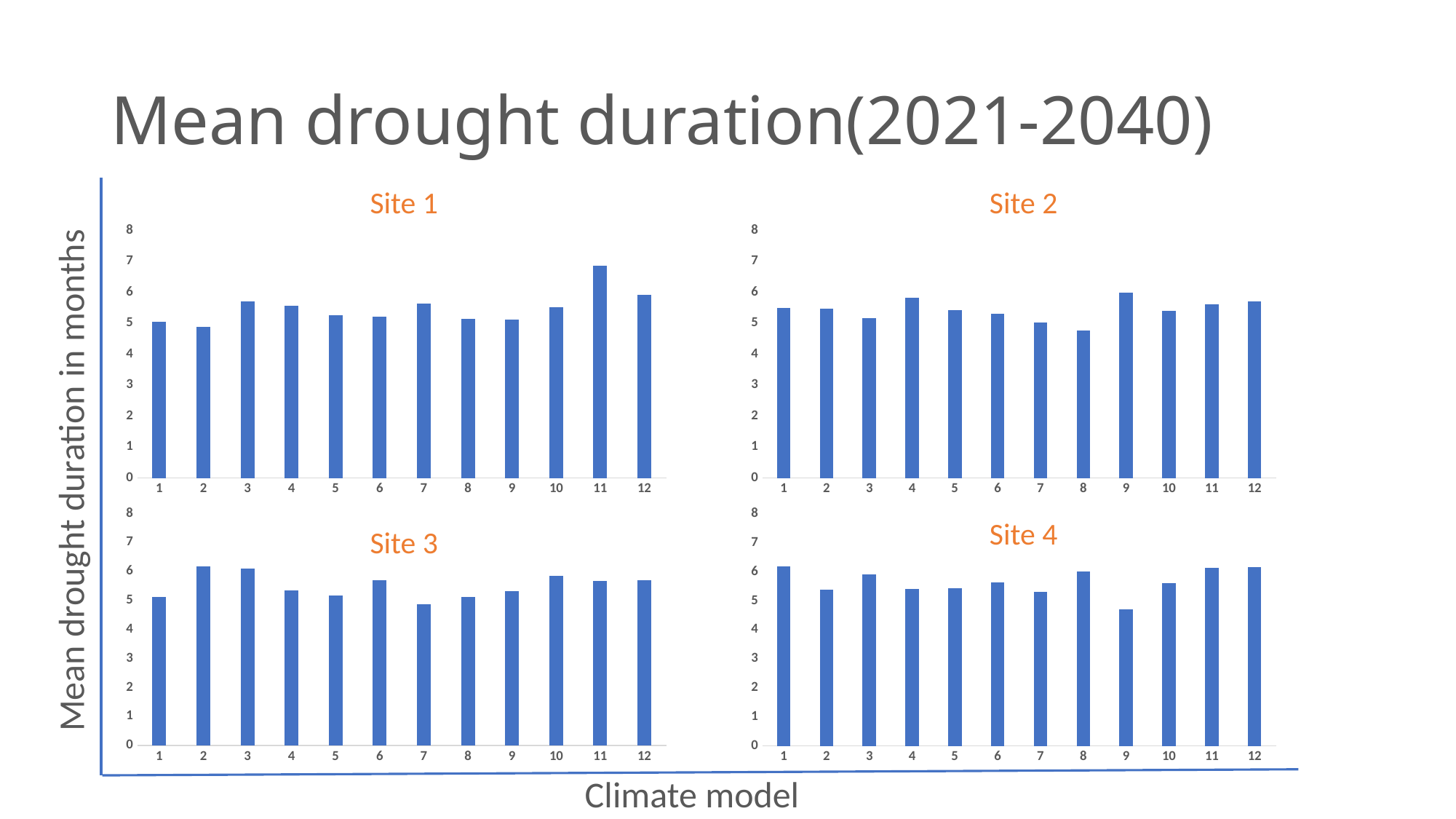
In the Site 4 chart, which is larger, the value for climate model 1 or climate model 9? climate model 1 In the Site 2 chart, is the value for climate model 8 greater or less than 5? less In the Site 3 chart, is the value for climate model 2 greater or less than 6? greater In the Site 1 chart, which climate model has the highest mean drought duration? 11 In the Site 4 chart, which climate model has the lowest mean drought duration? 9 In the Site 2 chart, which climate model has the lowest mean drought duration? 8 How many climate models are shown on the x axis of the Site 3 chart? 12 In the Site 1 chart, is the value for climate model 11 greater or less than 6? greater In the Site 3 chart, which climate model has the lowest mean drought duration? 7 What is the label of the shared y axis on the slide? Mean drought duration in months What kind of chart is used for Site 1? bar chart In the Site 2 chart, which is larger, the value for climate model 4 or climate model 8? climate model 4